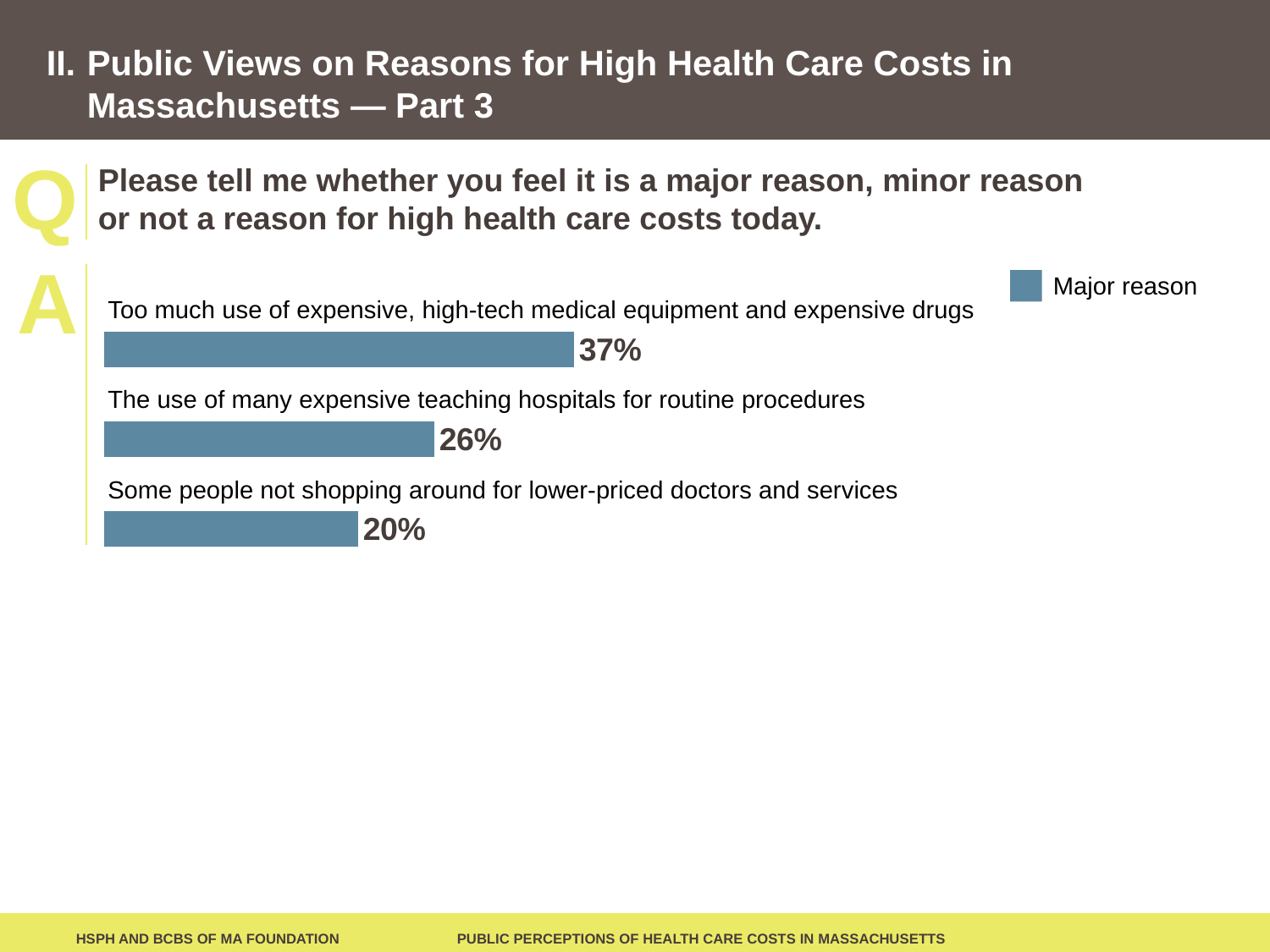
Which reason has the lowest share of respondents calling it a major reason? Some people not shopping around for lower-priced doctors and services What kind of chart is shown on the slide? Bar chart What is the difference in percentage points between the high-tech equipment and drugs bar and the teaching hospitals bar? 11 What percentage said some people not shopping around for lower-priced doctors and services is a major reason? 20% Which reason has the highest share of respondents calling it a major reason? Too much use of expensive, high-tech medical equipment and expensive drugs How many reasons are shown in the chart? 3 What percentage of respondents said too much use of expensive, high-tech medical equipment and expensive drugs is a major reason for high health care costs? 37% What percentage said the use of many expensive teaching hospitals for routine procedures is a major reason? 26% Which is larger: the share calling teaching hospitals a major reason or the share calling not shopping around a major reason? The use of many expensive teaching hospitals for routine procedures What is the difference in percentage points between the teaching hospitals bar and the not shopping around bar? 6 How many series does the legend list? 1 What is the legend entry for the bars in the chart? Major reason